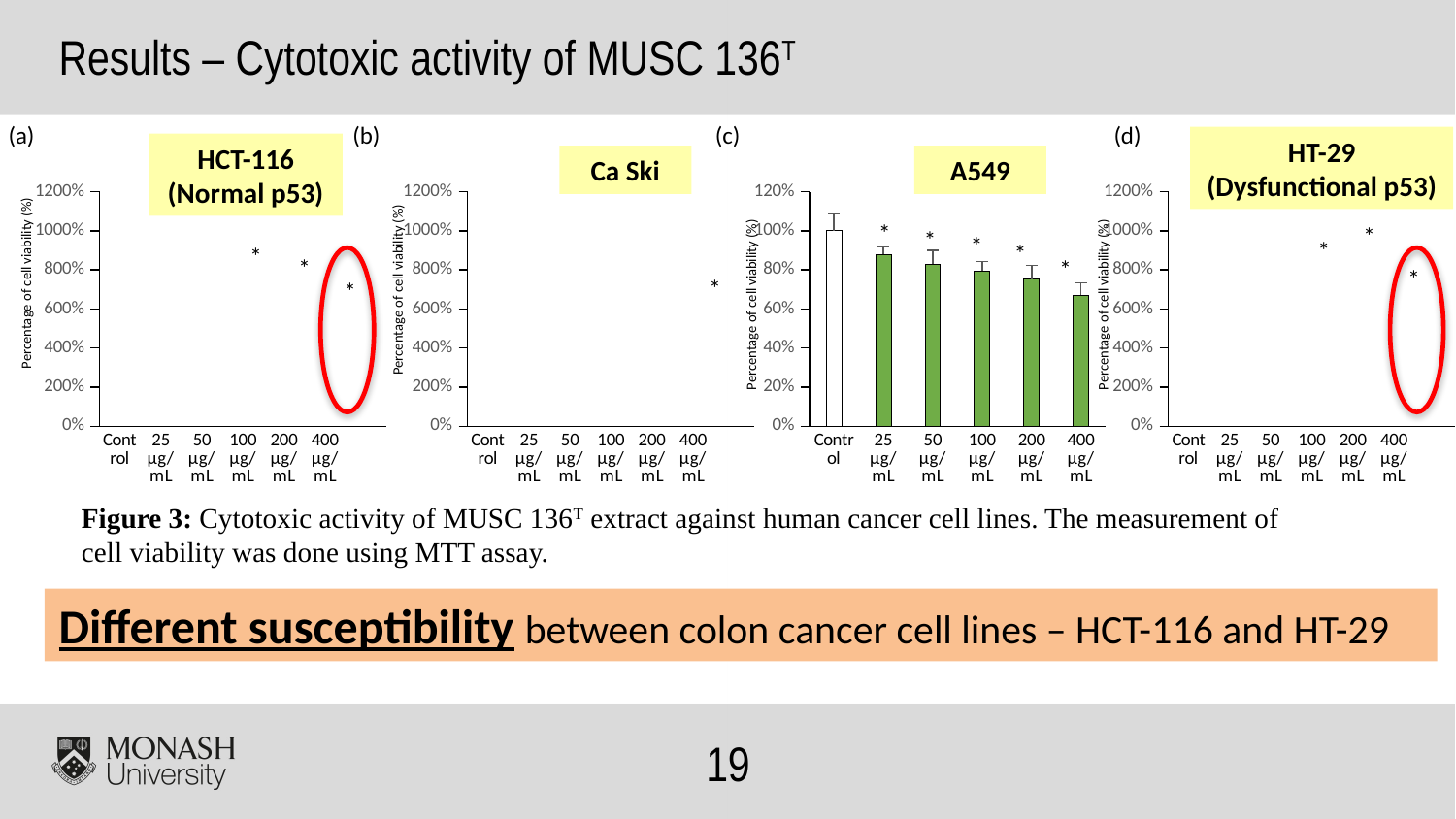
What kind of chart is the A549 chart (c)? bar chart In the A549 chart (c), is the value for 25 µg/mL greater or less than 80%? greater In the A549 chart (c), which is larger, the value for Control or the value for 200 µg/mL? Control In the A549 chart (c), do the bars rise or fall as the concentration increases along the x axis? fall In the A549 chart (c), which is larger, the value for 25 µg/mL or the value for 400 µg/mL? 25 µg/mL In the A549 chart (c), which category has the lowest cell viability? 400 µg/mL In the A549 chart (c), is the value for 400 µg/mL greater or less than 80%? less In the A549 chart (c), is the value for 50 µg/mL greater or less than 60%? greater In the A549 chart (c), which category has the highest cell viability? Control How many categories are shown on the x axis of the A549 chart (c)? 6 What is the highest tick value on the y axis of the HCT-116 chart (a)? 1200% What is the title of chart (d)? HT-29 (Dysfunctional p53)